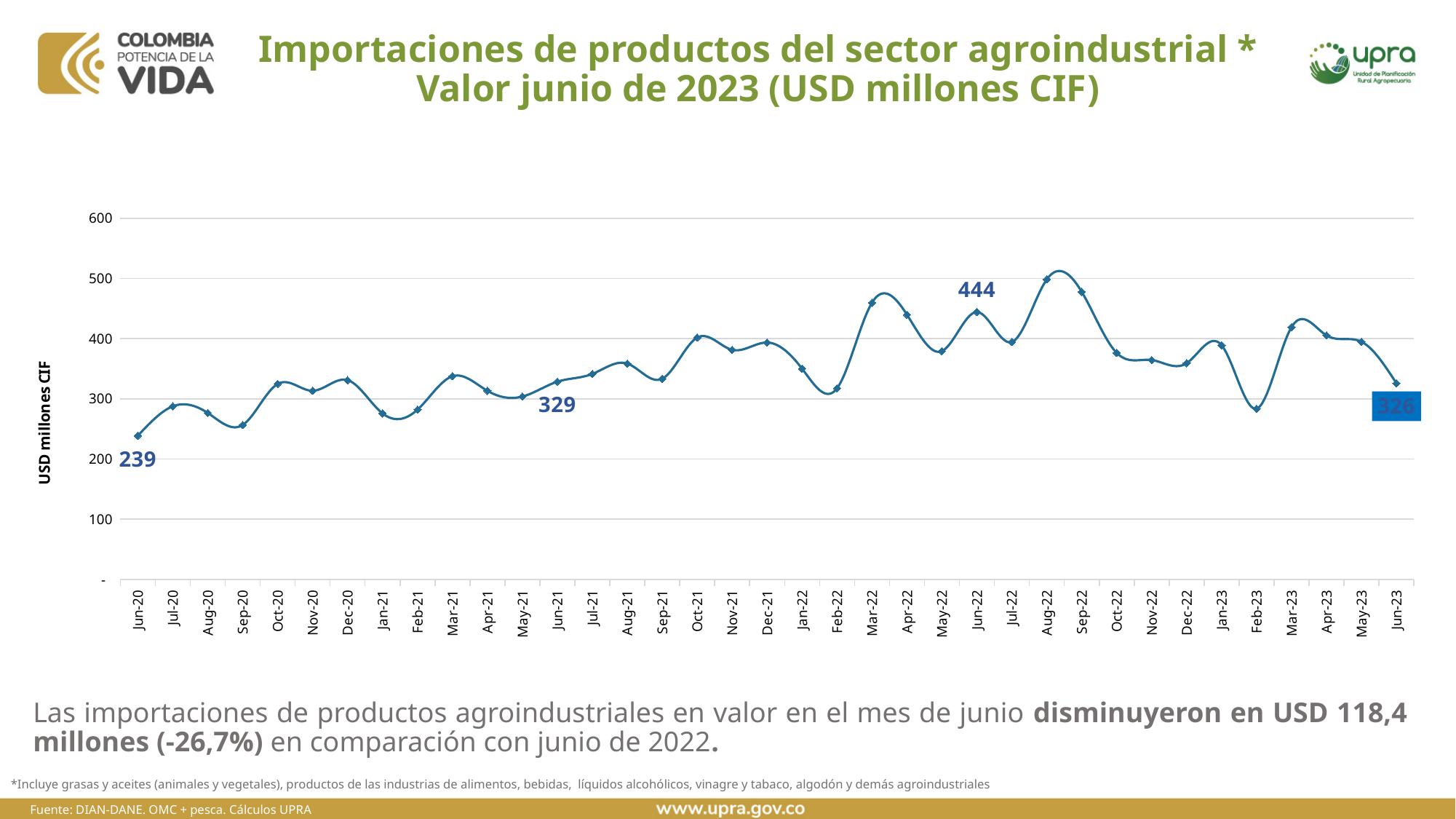
What type of chart is shown on the slide? line chart What is the value for Jun-20? 239 What is the value for Jun-21? 329 What is the difference between the values for Jun-22 and Jun-23? 118 What is the label of the vertical axis? USD millones CIF Is the value for Feb-23 greater or less than 300? less Which month has the lowest value on the chart? Jun-20 What is the value for Jun-23? 326 Is the value for Mar-22 greater or less than 400? greater Which month has the highest value on the chart? Aug-22 Which is larger, the value for Jun-22 or the value for Jun-23? Jun-22 What is the value for Jun-22? 444